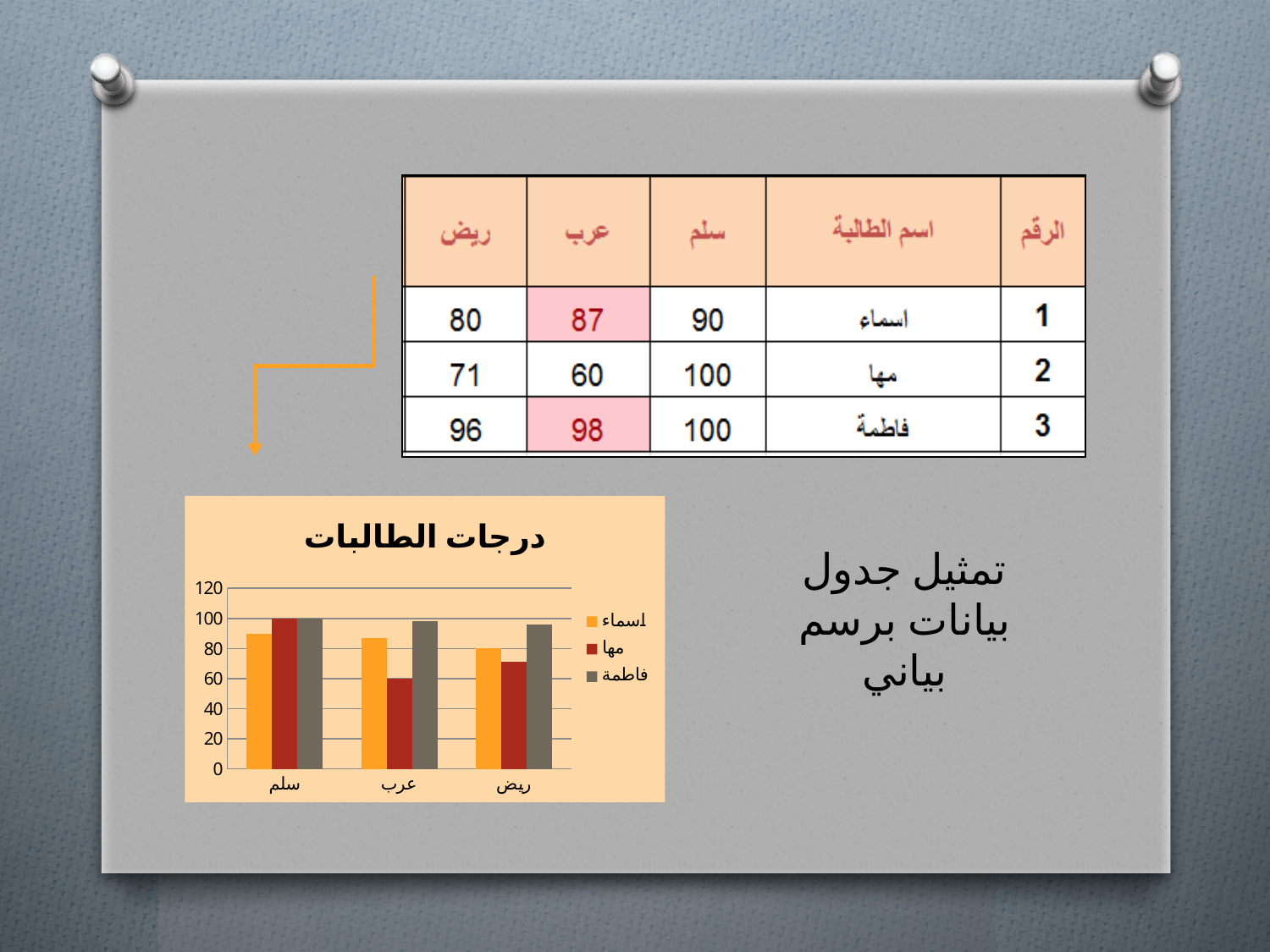
What is the title of the chart? درجات الطالبات Is the value for اسماء in the سلم category greater or less than 80? greater How many series does the chart legend list? 3 Which series has the highest value in the ريض category? فاطمة Is the value for مها in the ريض category greater or less than 80? less How many categories are shown on the x axis of the chart? 3 What kind of chart is shown on the slide? bar chart What is the value for مها in the عرب category? 60 What is the value for مها in the سلم category? 100 What is the value for فاطمة in the سلم category? 100 In the عرب category, which is larger: the value for اسماء or the value for مها? اسماء Which series has the lowest value in the عرب category? مها